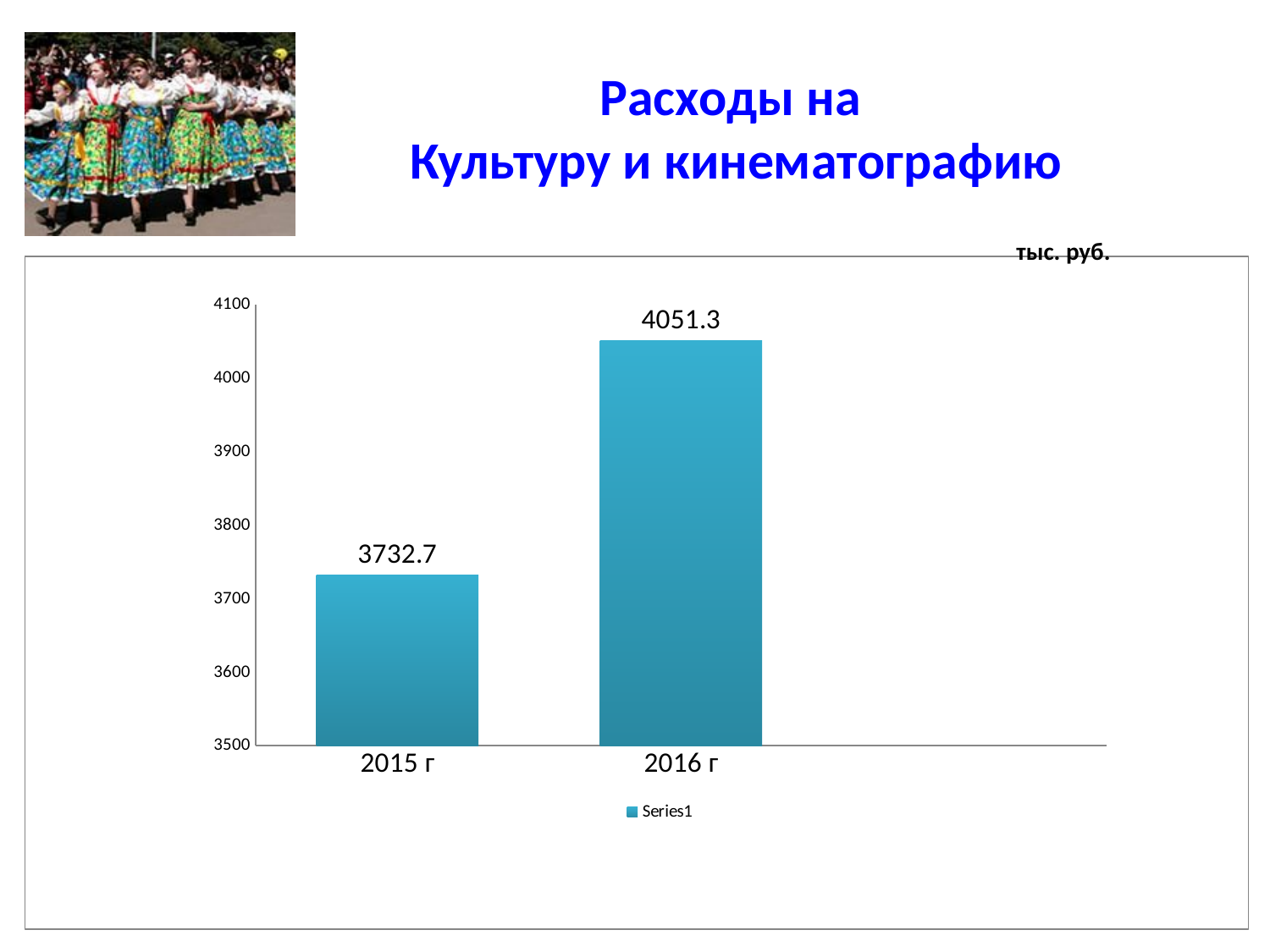
What is the value for 2015 г? 3732.7 How many categories are shown on the x axis? 2 What is the value for 2016 г? 4051.3 What is the difference between the values for 2016 г and 2015 г? 318.6 Do the values rise or fall from 2015 г to 2016 г? rise Is the value for 2015 г greater or less than 3800? less Is the value for 2016 г greater or less than 4000? greater Which is larger, the value for 2015 г or the value for 2016 г? 2016 г How many series does the legend list? 1 What kind of chart is shown on the slide? bar chart Which year has the highest value? 2016 г Which year has the lowest value? 2015 г